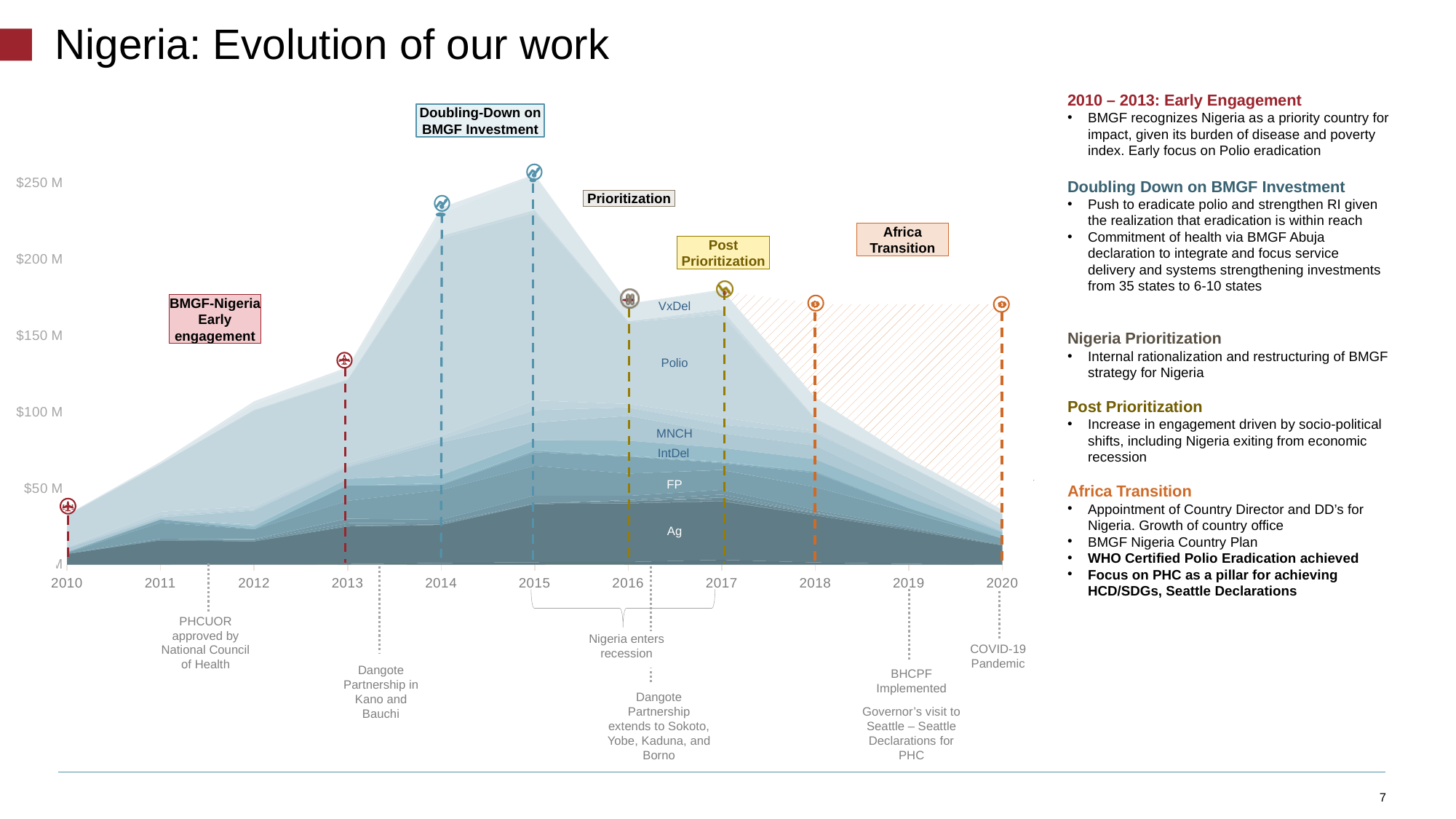
Which series is plotted at the bottom of the stacked area chart? Ag Do the total values rise or fall from 2015 to 2020? fall Is the total value for 2010 greater or less than $50 M? less Is the total value for 2020 greater or less than $50 M? less Is the total value for 2013 greater or less than $100 M? greater Which year has a larger total investment, 2014 or 2017? 2014 What kind of chart is shown on the slide? Stacked area chart In which year does the total investment reach its highest point? 2015 How many years are shown along the x axis of the chart? 11